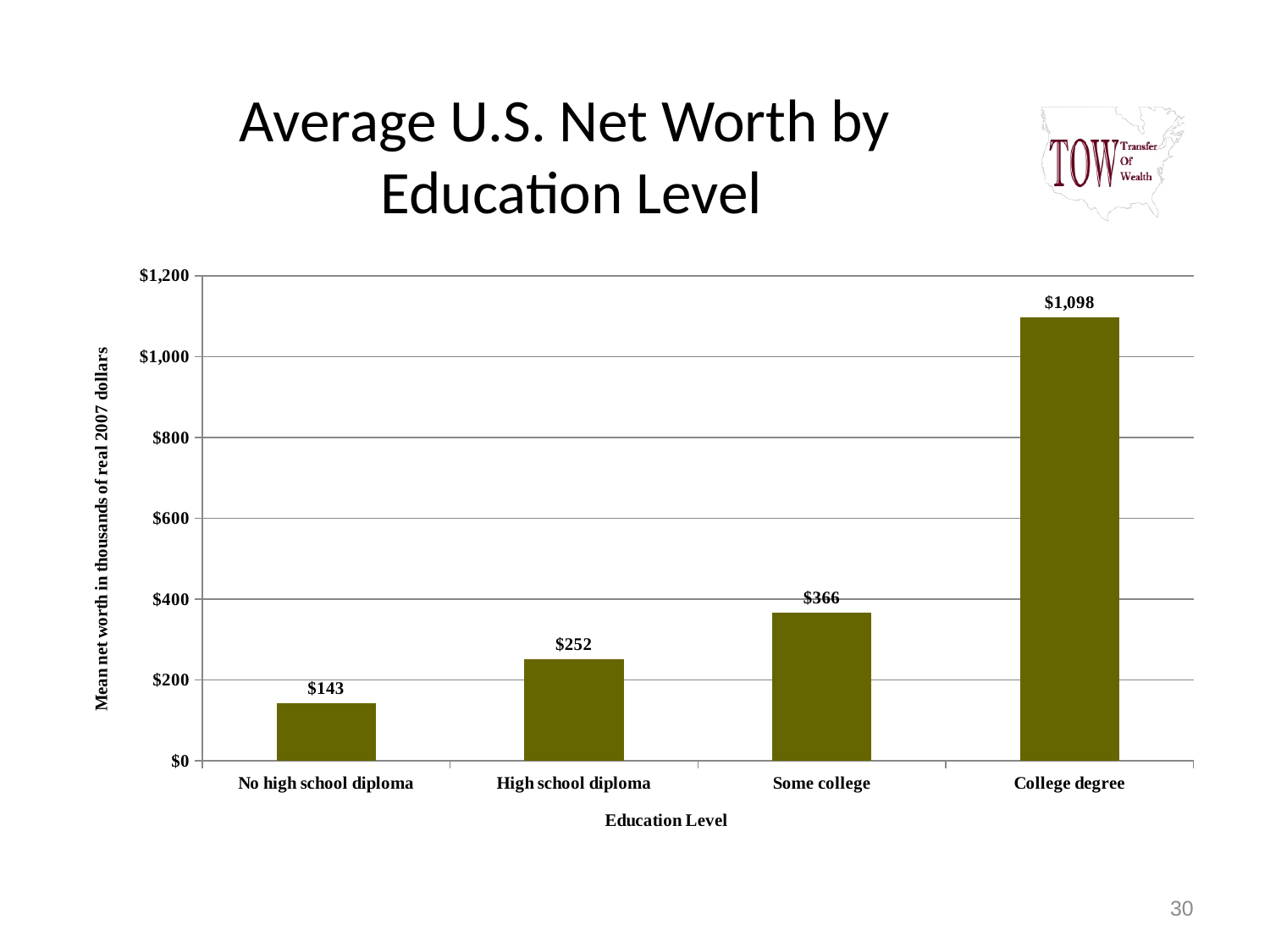
Do the values rise or fall as education level increases from left to right? Rise What is the difference in mean net worth between College degree and Some college? $732 What kind of chart is shown on the slide? Bar chart Which education level has the highest mean net worth? College degree Is the value for Some college greater or less than $400? less What is the difference in mean net worth between High school diploma and No high school diploma? $109 Which has a larger mean net worth, High school diploma or Some college? Some college How many education level categories are shown in the chart? 4 Which education level has the lowest mean net worth? No high school diploma What is the mean net worth for the No high school diploma category? $143 What is the mean net worth for the Some college category? $366 What is the mean net worth for the College degree category? $1,098